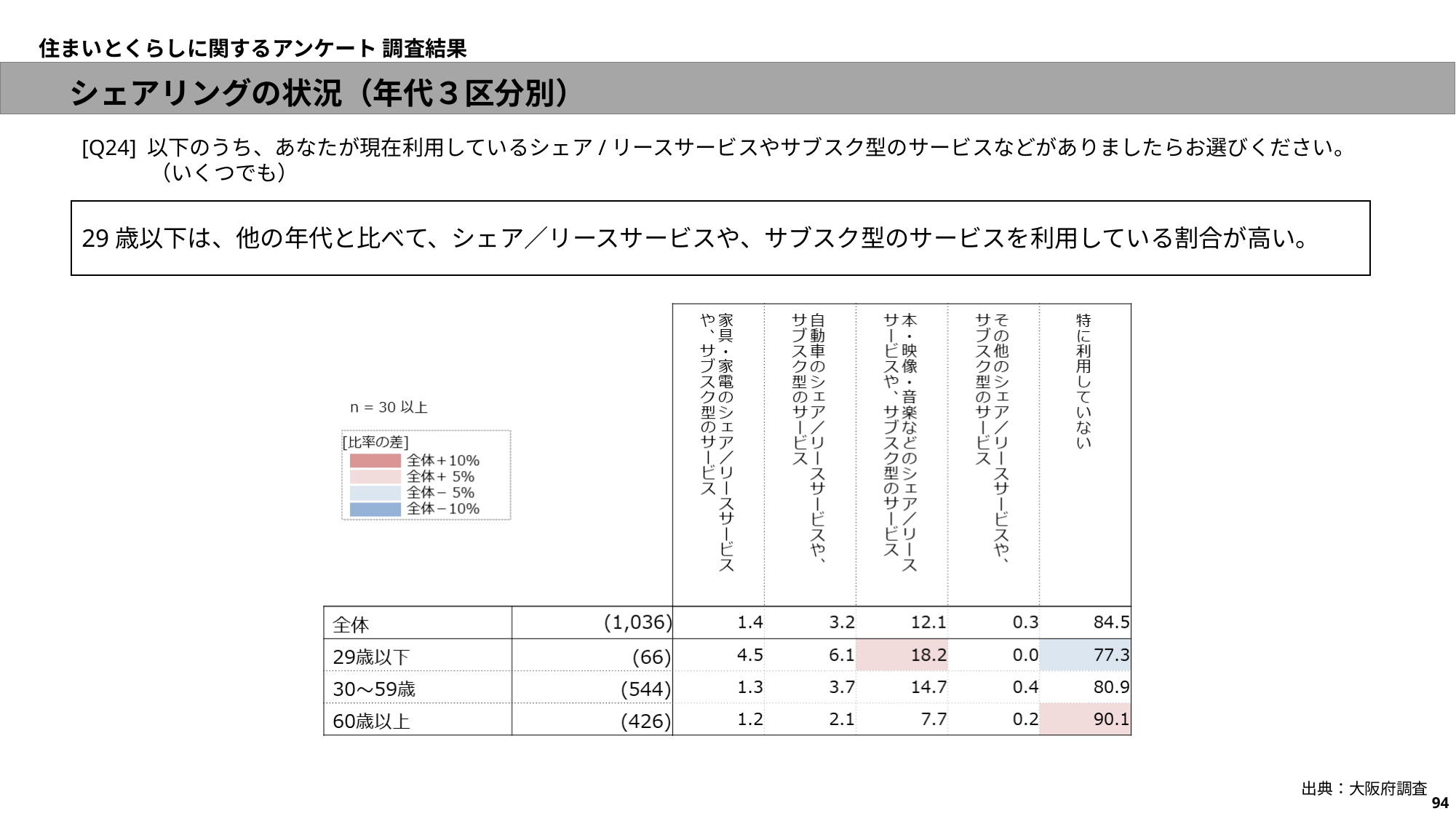
What is the value for 全体 in the 自動車のシェア／リースサービスや、サブスク型のサービス column? 3.2 Which age group has the lowest value in the 本・映像・音楽などのシェア／リースサービスや、サブスク型のサービス column? 60歳以上 How many service categories (columns) are shown in the table? 5 What is the sample size (n) shown for 30〜59歳? (544) Which is larger in the 家具・家電のシェア／リースサービスや、サブスク型のサービス column: 29歳以下 or 30〜59歳? 29歳以下 According to the legend [比率の差], what does the darkest red colour represent? 全体＋10% Which age group has the highest value in the 特に利用していない column? 60歳以上 What is the value for 29歳以下 in the その他のシェア／リースサービスや、サブスク型のサービス column? 0.0 How many age-group rows (excluding 全体) are shown in the table? 3 What is the value for 60歳以上 in the 特に利用していない column? 90.1 What is the difference between 29歳以下 and 60歳以上 in the 特に利用していない column? 12.8 What is the value for 29歳以下 in the 本・映像・音楽などのシェア／リースサービスや、サブスク型のサービス column? 18.2